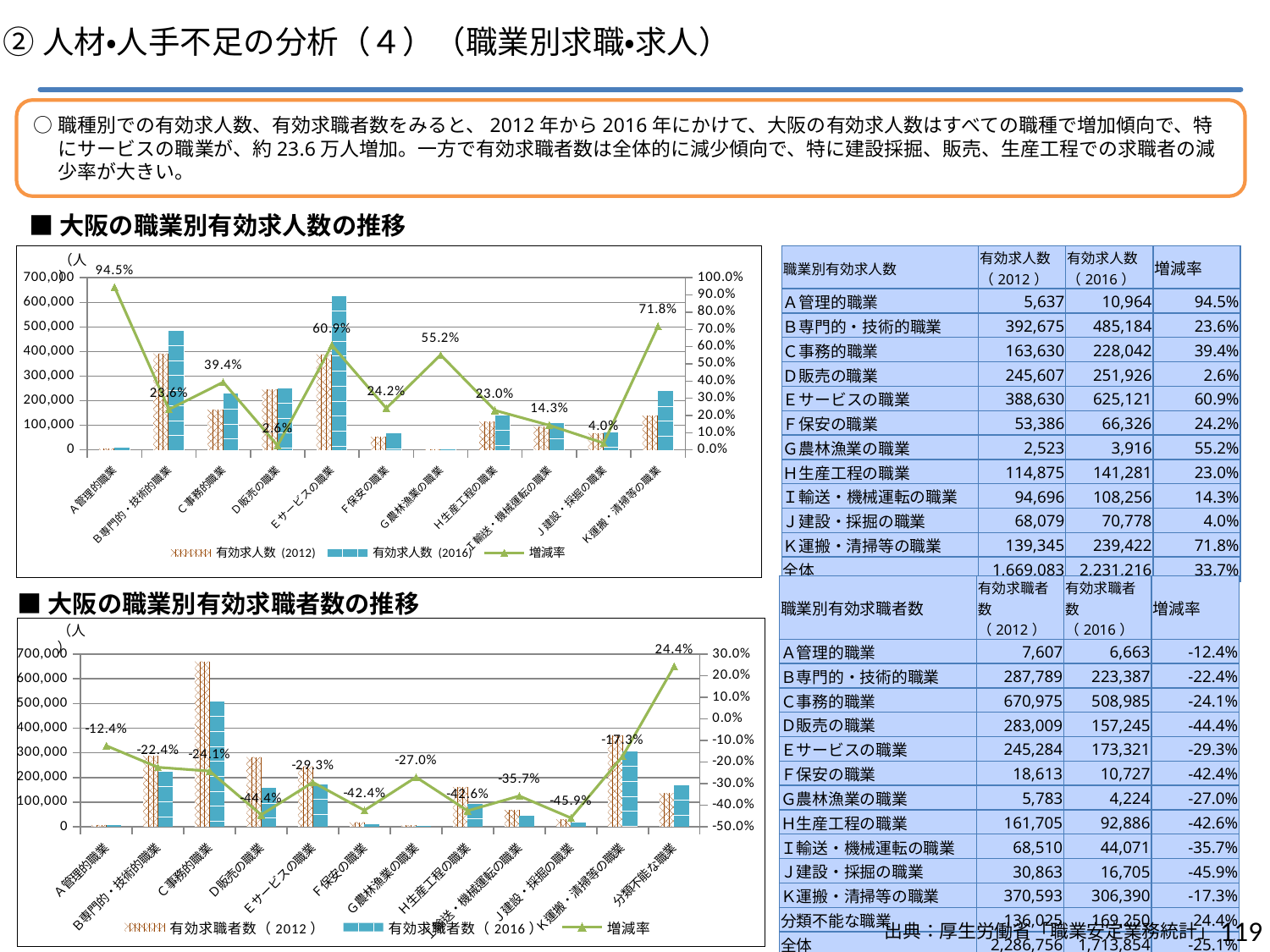
In the top chart (大阪の職業別有効求人数の推移), is the 有効求人数 (2016) bar for Eサービスの職業 greater or less than 500,000? greater In the top chart (大阪の職業別有効求人数の推移), which occupation has the highest 増減率? A管理的職業 What kind of chart is the bottom chart (大阪の職業別有効求職者数の推移)? A bar chart combined with a line In the top chart (大阪の職業別有効求人数の推移), what is the difference in percentage points between the 増減率 of Eサービスの職業 (60.9%) and C事務的職業 (39.4%)? 21.5 percentage points In the top chart (大阪の職業別有効求人数の推移), which occupation has the lowest 増減率? D販売の職業 How many occupation categories are shown on the x axis of the top chart (大阪の職業別有効求人数の推移)? 11 In the bottom chart (大阪の職業別有効求職者数の推移), which occupation has the highest 増減率? 分類不能な職業 In the top chart (大阪の職業別有効求人数の推移), which has the larger 増減率: K運搬・清掃等の職業 or G農林漁業の職業? K運搬・清掃等の職業 In the bottom chart (大阪の職業別有効求職者数の推移), what is the 増減率 for D販売の職業? -44.4% In the top chart (大阪の職業別有効求人数の推移), what is the 増減率 for A管理的職業? 94.5% In the bottom chart (大阪の職業別有効求職者数の推移), is the 有効求職者数 (2012) bar for C事務的職業 greater or less than 600,000? greater How many series does the legend of the top chart (大阪の職業別有効求人数の推移) list? 3